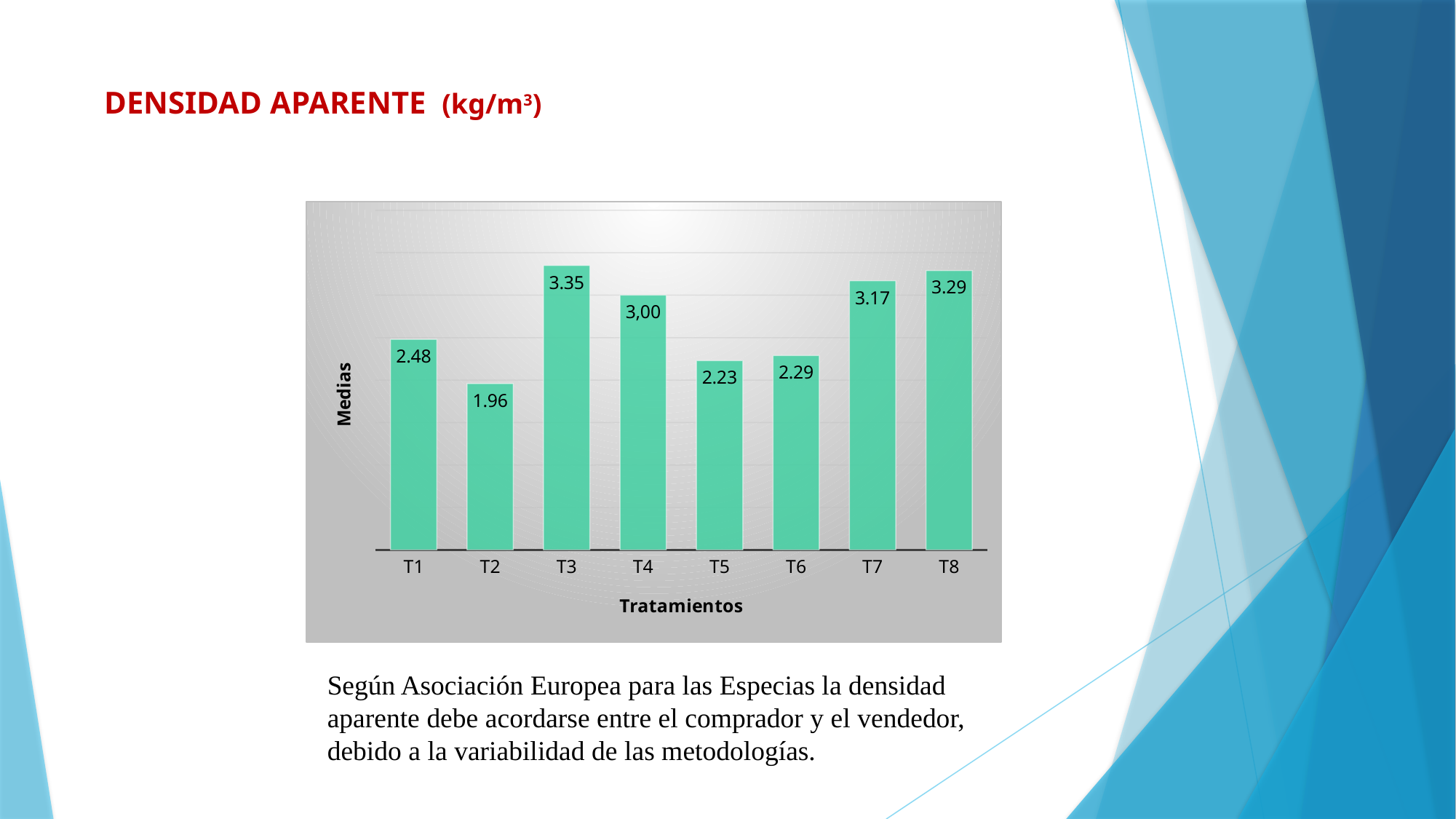
Which treatment has the highest value? T3 What is the label of the x axis? Tratamientos What is the value for T1? 2.48 What is the value for T6? 2.29 Which treatment has the lowest value? T2 What is the difference between the values for T8 and T7? 0.12 Which is larger, the value for T4 or the value for T7? T7 How many treatments are shown on the x axis? 8 What is the value for T7? 3.17 What kind of chart is shown on the slide? Bar chart What is the difference between the values for T3 and T2? 1.39 What is the value for T4? 3,00